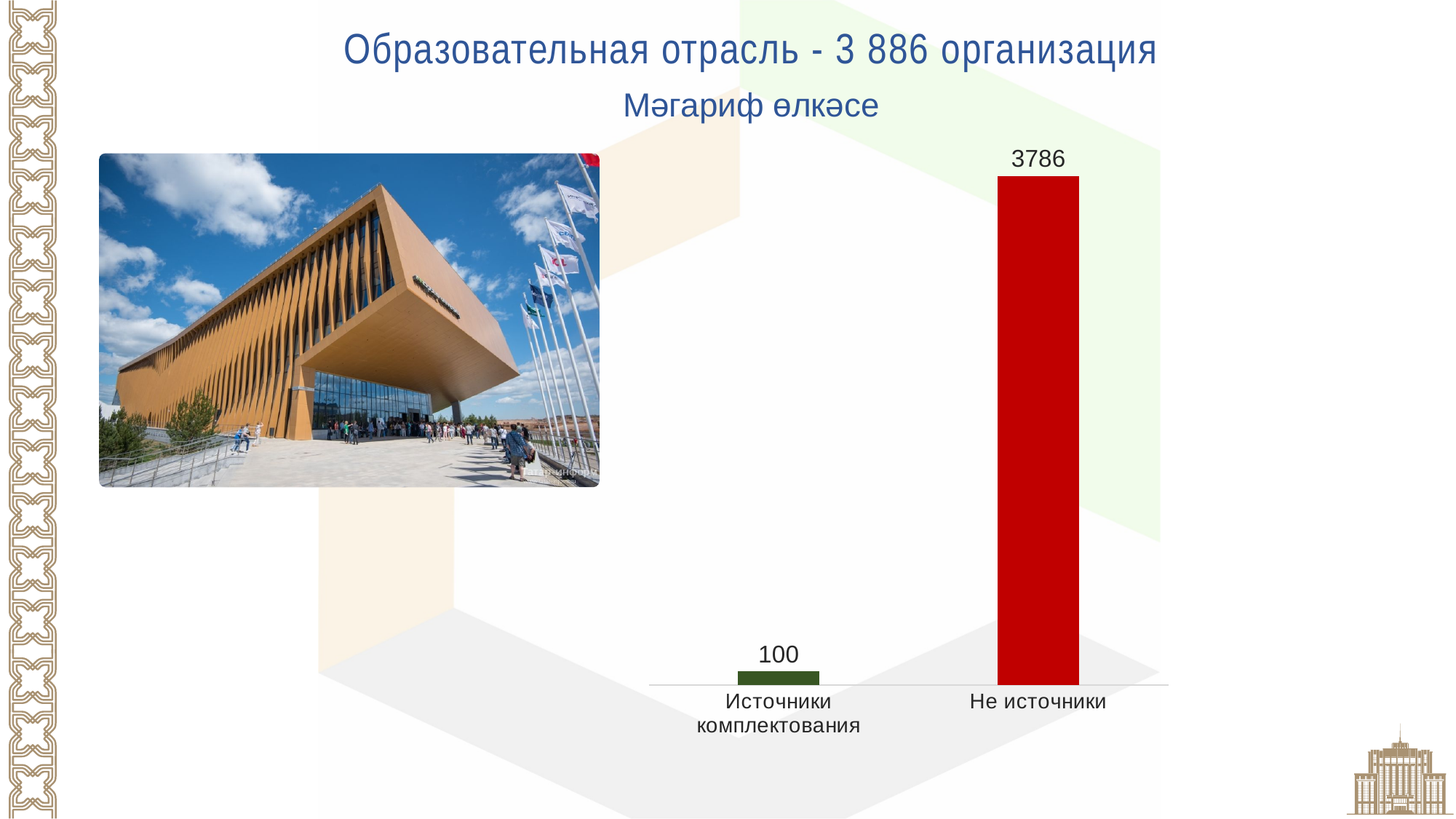
What is the total of the two values shown in the chart? 3886 Which category has the highest value? Не источники What kind of chart is shown on the slide? bar chart Which category has the lowest value? Источники комплектования What is the value for "Источники комплектования"? 100 What colour is the bar for "Источники комплектования"? green What is the difference between the values for "Не источники" and "Источники комплектования"? 3686 How many categories are shown in the chart? 2 Which is larger: the value for "Источники комплектования" or the value for "Не источники"? Не источники What is the value for "Не источники"? 3786 What colour is the bar for "Не источники"? red